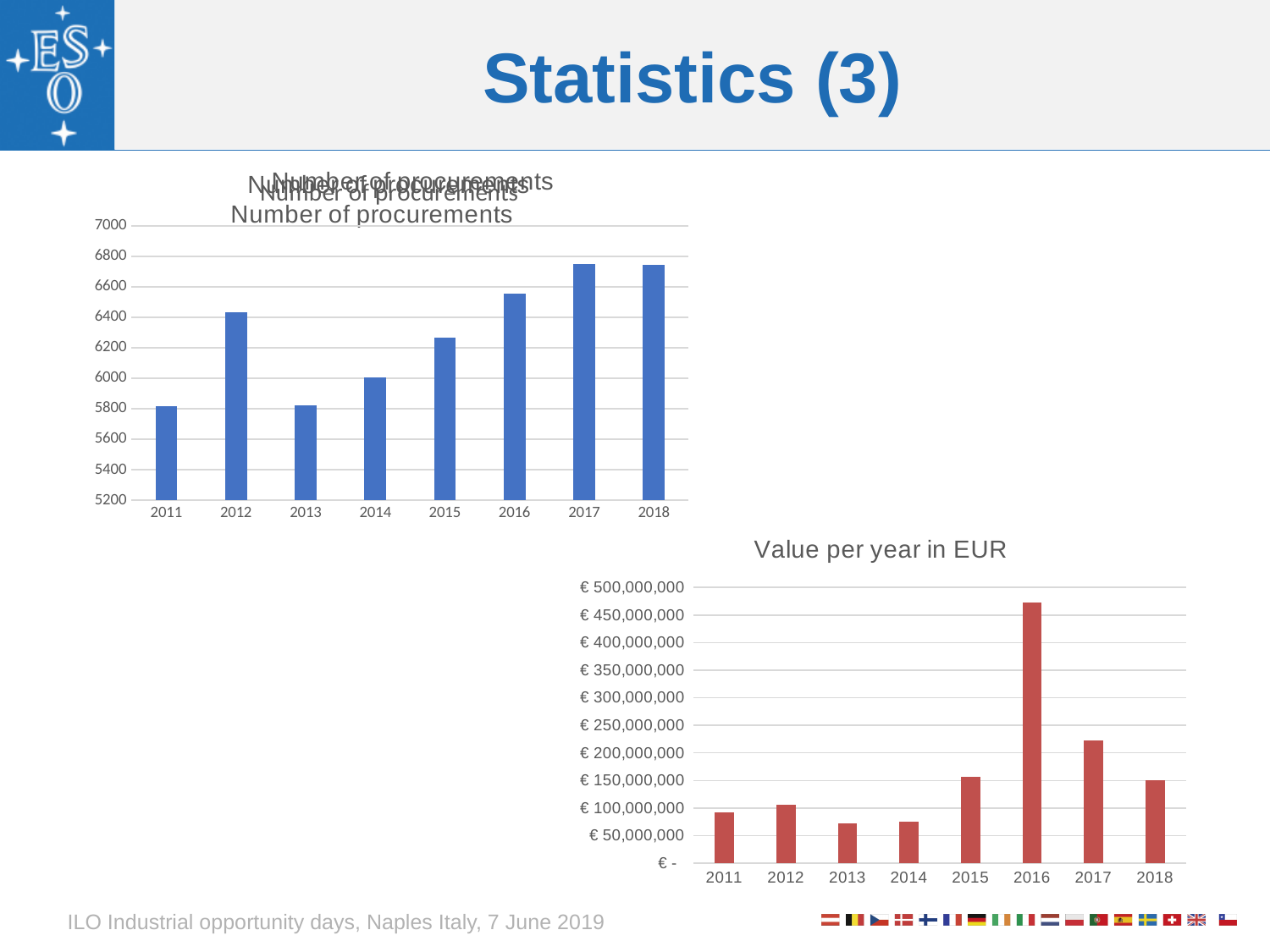
In the 'Value per year in EUR' chart, how many years are shown on the x axis? 8 In the 'Number of procurements' chart, is the value for 2016 greater or less than 6400? greater In the 'Value per year in EUR' chart, is the value for 2016 greater or less than € 400,000,000? greater In the 'Number of procurements' chart, how many years are shown on the x axis? 8 In the 'Value per year in EUR' chart, which year has the larger value, 2017 or 2018? 2017 In the 'Value per year in EUR' chart, is the value for 2013 greater or less than € 100,000,000? less In the 'Number of procurements' chart, which year has the larger value, 2012 or 2013? 2012 What kind of chart is the 'Number of procurements' chart? bar chart In the 'Value per year in EUR' chart, which year has the highest value? 2016 What kind of chart is the 'Value per year in EUR' chart? bar chart